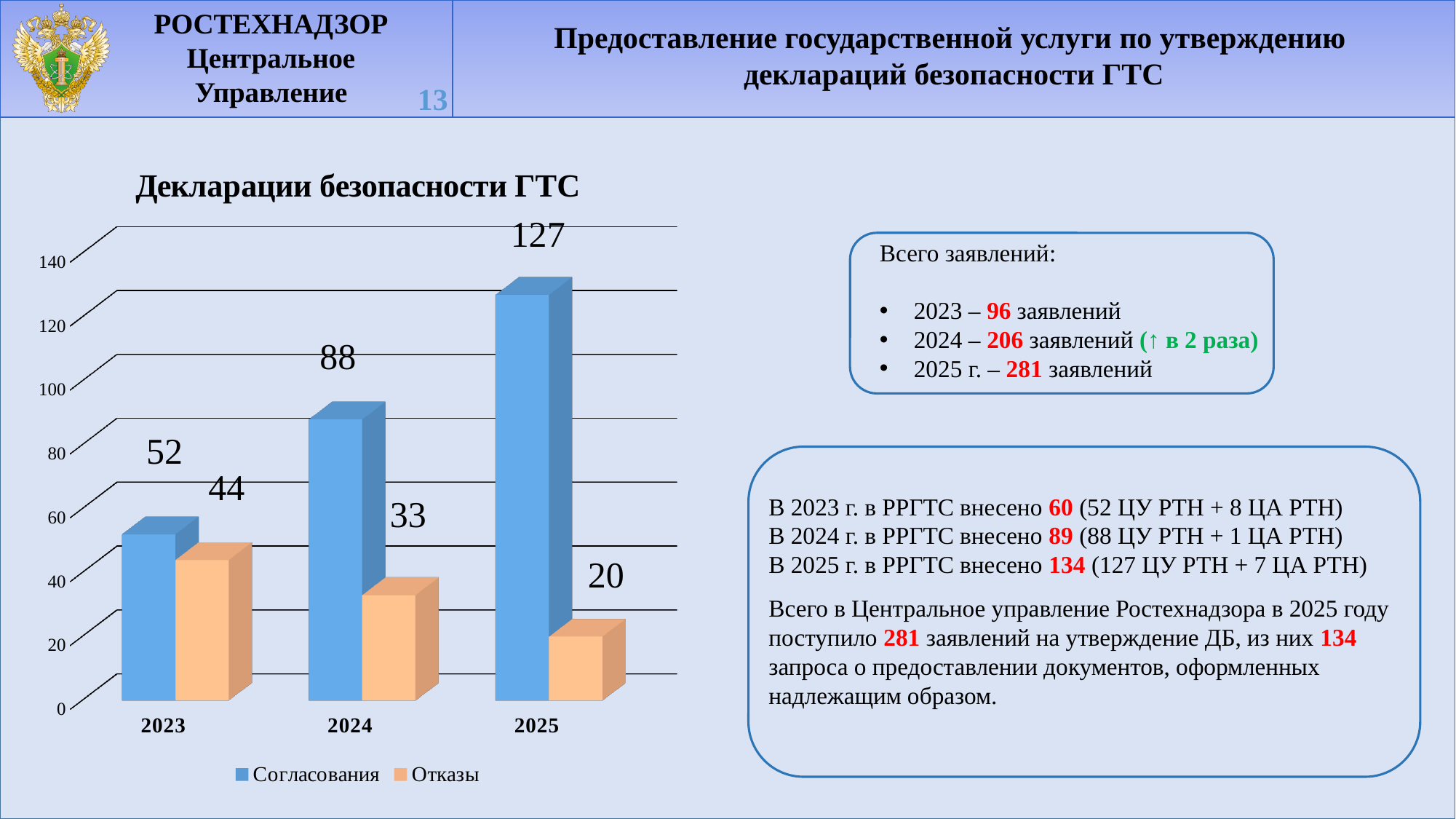
What is the difference between Согласования and Отказы in 2024? 55 What is the value of Согласования for 2024? 88 What is the value of Отказы for 2023? 44 Which year has the highest value for Согласования? 2025 Do the values for Отказы rise or fall from 2023 to 2025? Fall What kind of chart is shown? Bar chart What is the title of the chart? Декларации безопасности ГТС Which year has the lowest value for Отказы? 2025 How many series does the legend list? 2 How many years are shown on the x axis? 3 What is the value of Согласования for 2025? 127 Which is larger in 2023: Согласования or Отказы? Согласования